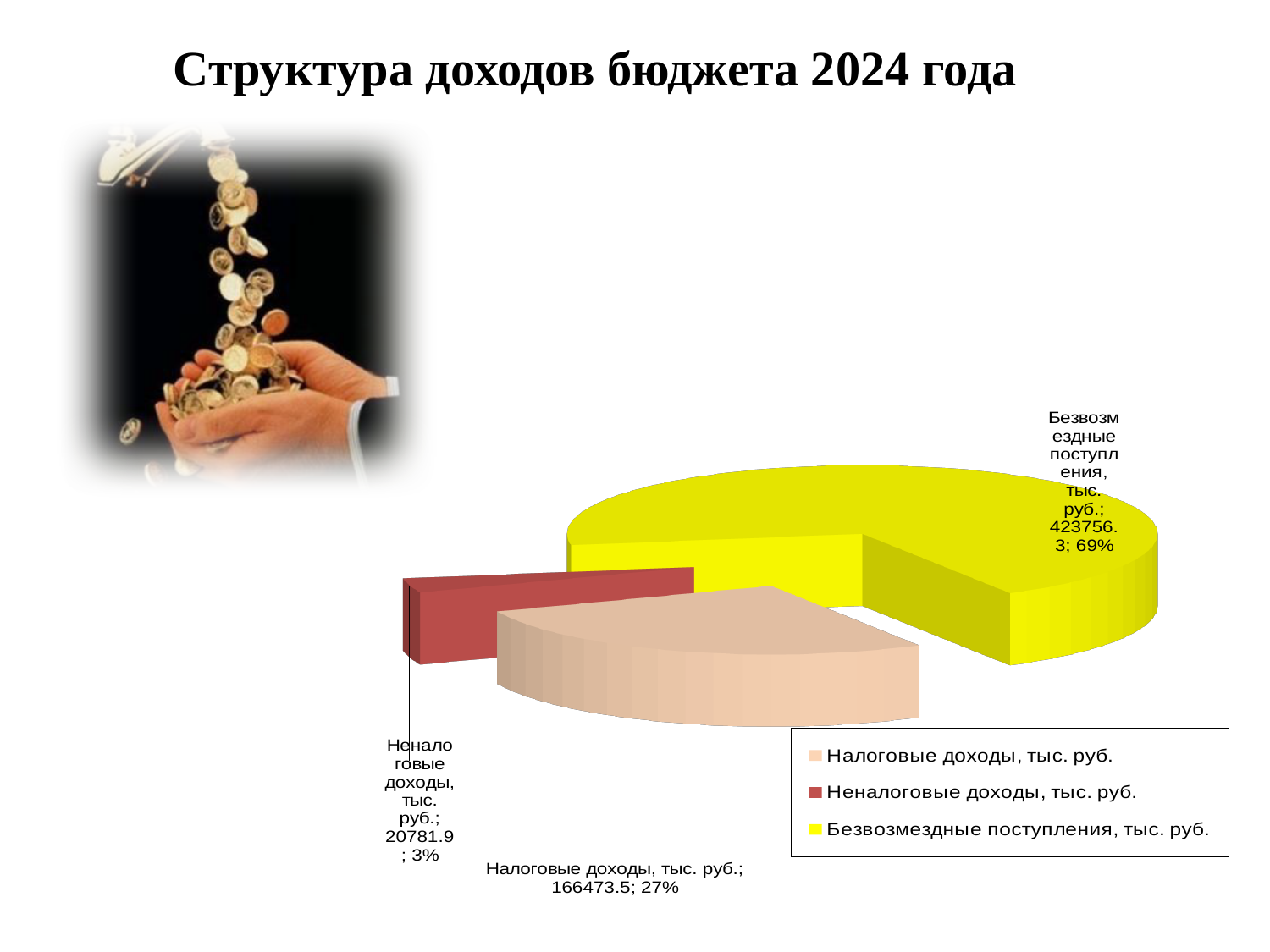
What share of the pie does Безвозмездные поступления represent? 69% How many categories does the pie chart show? 3 What is the title of the slide containing the chart? Структура доходов бюджета 2024 года What share of the pie does Налоговые доходы represent? 27% What is the value for Налоговые доходы, тыс. руб.? 166473.5 What is the value for Безвозмездные поступления, тыс. руб.? 423756.3 Which category has the largest slice of the pie? Безвозмездные поступления, тыс. руб. What is the difference between the values for Безвозмездные поступления and Налоговые доходы? 257282.8 What is the value for Неналоговые доходы, тыс. руб.? 20781.9 What share of the pie does Неналоговые доходы represent? 3% What kind of chart is shown on the slide? Pie chart Which category has the smallest slice of the pie? Неналоговые доходы, тыс. руб.